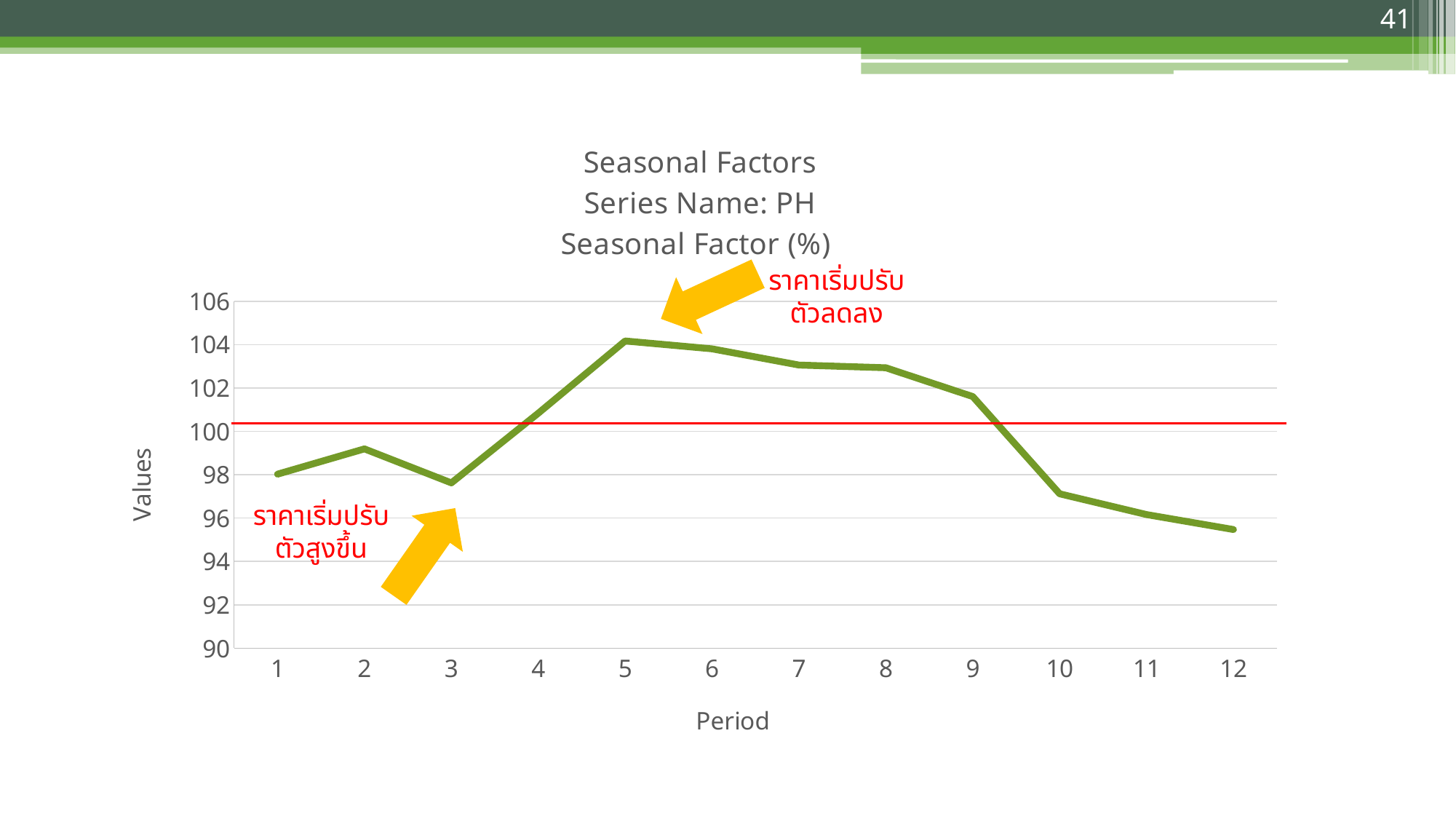
What is the label of the x axis? Period Is the value for period 12 greater or less than 96? less What kind of chart is shown on the slide? line chart What is the series name given in the chart title? PH Is the value for period 9 greater or less than 100? greater Do the values rise or fall from period 5 to period 12? fall Which has the larger value, period 2 or period 3? period 2 Which period has the highest seasonal factor value? 5 Which period has the lowest seasonal factor value? 12 How many periods are plotted on the x axis? 12 Is the value for period 5 greater or less than 102? greater